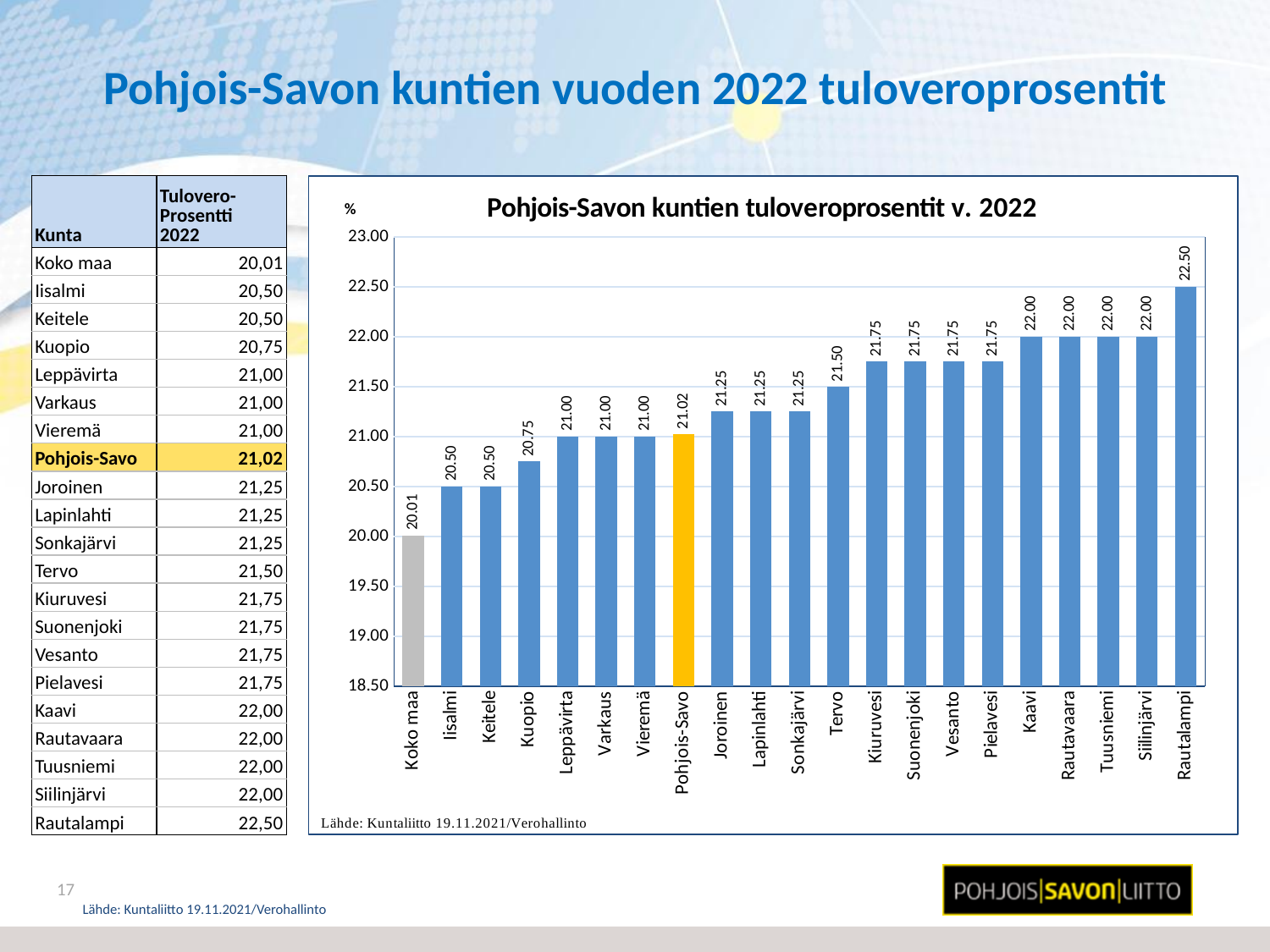
What is the difference between the values for Rautalampi and Koko maa? 2.49 How many bars are shown in the chart? 21 Which category has the lowest value? Koko maa Which is larger, the value for Kiuruvesi or the value for Joroinen? Kiuruvesi What is the value shown for Tervo? 21.50 What kind of chart is shown? Bar chart What is the difference between the values for Kaavi and Kuopio? 1.25 What is the value shown for Rautalampi? 22.50 Which category has the highest value? Rautalampi What is the value shown for Pohjois-Savo? 21.02 What is the title of the chart? Pohjois-Savon kuntien tuloveroprosentit v. 2022 What is the value shown for Koko maa? 20.01